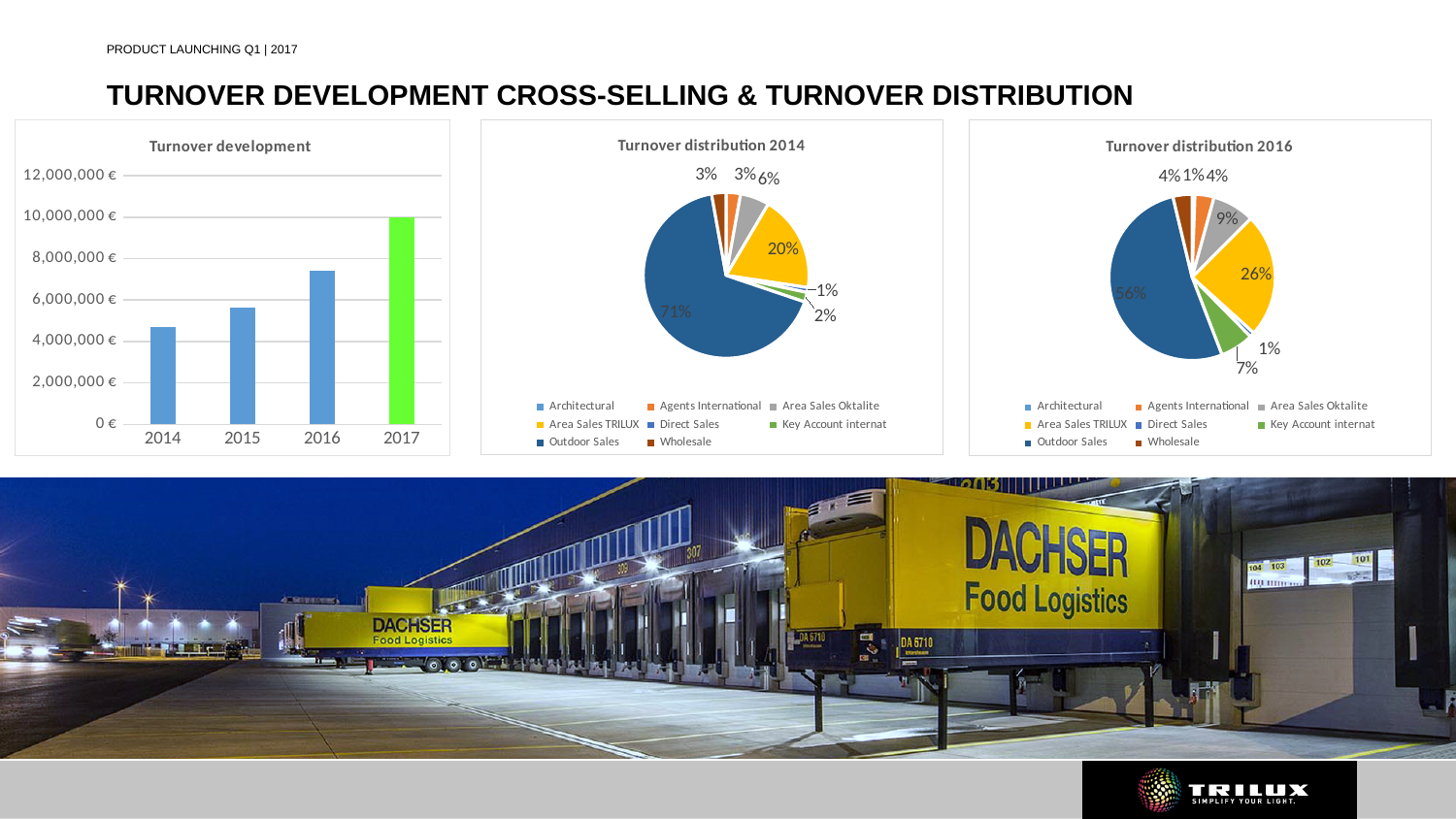
In the 'Turnover development' chart, do the values rise or fall from 2014 to 2017? rise What type of chart is the 'Turnover development' chart? bar chart In the 'Turnover development' chart, which year has the lowest turnover? 2014 In the 'Turnover distribution 2016' pie chart, what is the share of the largest slice? 56% How many entries does the legend of the 'Turnover distribution 2016' pie chart list? 8 In the 'Turnover development' chart, what colour is the bar for 2017? green In the 'Turnover development' chart, is the value for 2014 greater or less than 6,000,000 €? less In the 'Turnover distribution 2014' pie chart, what is the share of the largest slice? 71% In the 'Turnover development' chart, is the value for 2016 greater or less than 6,000,000 €? greater In the 'Turnover development' chart, is the value for 2017 greater or less than 8,000,000 €? greater In the 'Turnover development' chart, which year has the highest turnover? 2017 In the 'Turnover development' chart, how many years are shown on the x axis? 4